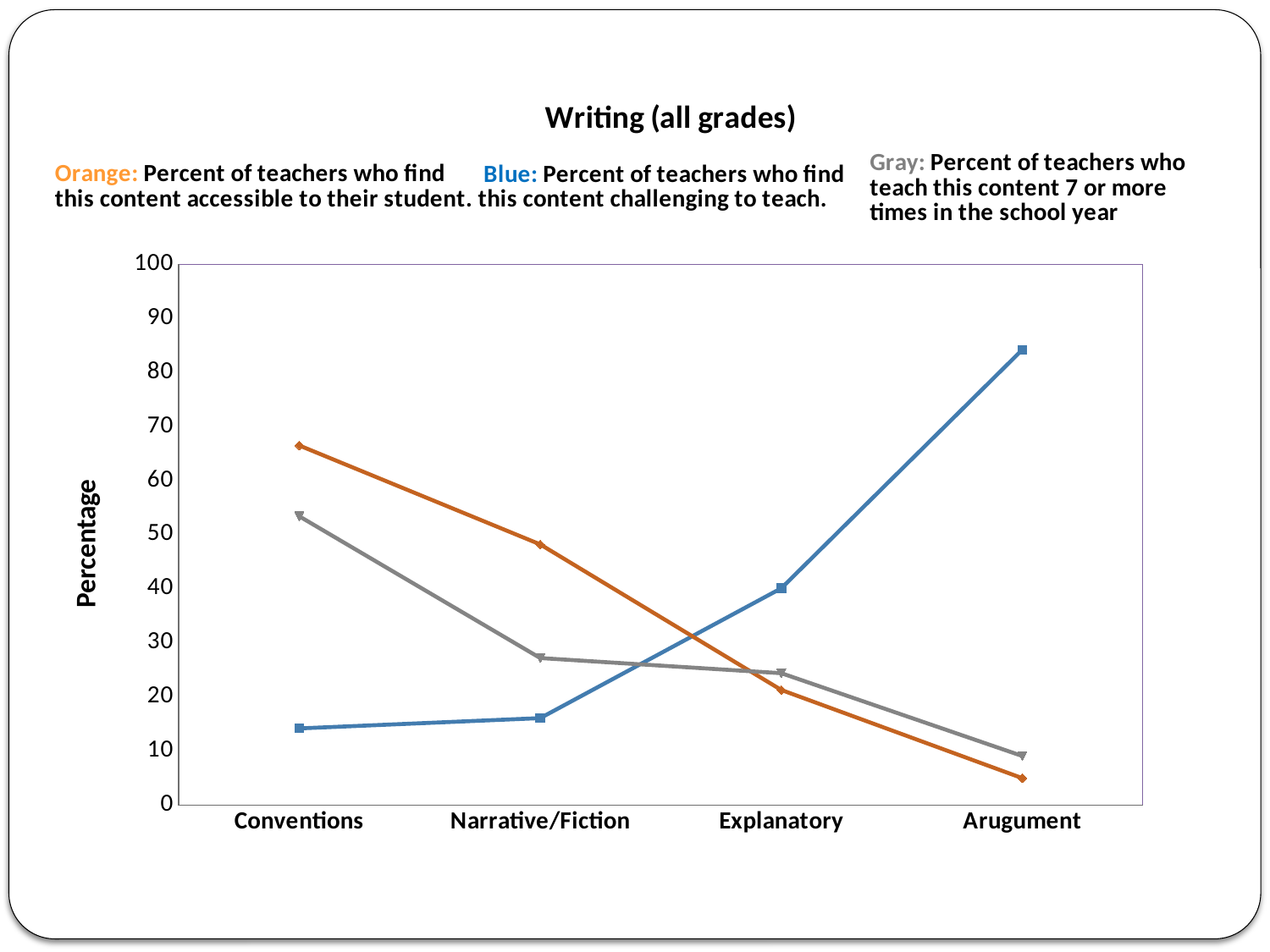
How many categories are shown on the x axis of the chart? 4 Is the blue line's value for Arugument greater or less than 80? greater Is the orange line's value for Conventions greater or less than 60? greater What kind of chart is shown on the slide? line chart Does the orange line rise or fall from Conventions to Arugument? fall For which category is the orange line (percent of teachers who find this content accessible to their student) lowest? Arugument For which category is the blue line (percent of teachers who find this content challenging to teach) highest? Arugument How many data series are plotted on the chart? 3 What is the title of the chart? Writing (all grades) At Explanatory, which is larger: the blue line's value or the orange line's value? blue Is the blue line's value for Conventions greater or less than 20? less Does the blue line rise or fall from Conventions to Arugument? rise